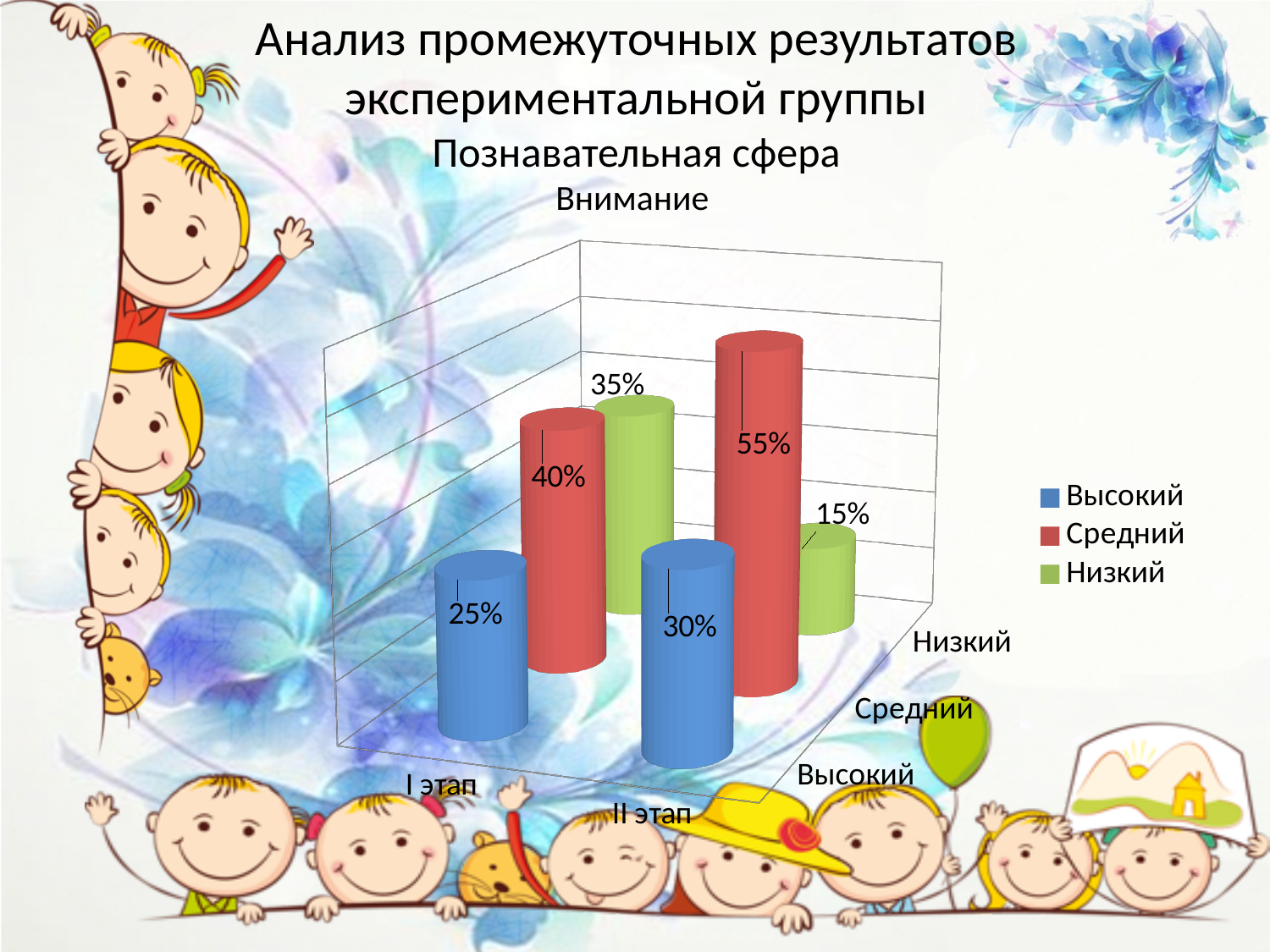
How many series does the legend list? 3 What is the value for Низкий at I этап? 35% How many stages (categories) are shown on the x axis? 2 What is the difference between the Средний values at II этап and I этап? 15% What is the value for Высокий at I этап? 25% What is the value for Средний at II этап? 55% Which series has the lowest value at I этап? Высокий What kind of chart is shown? Bar chart What is the value for Низкий at II этап? 15% Which series has the highest value at II этап? Средний Which is larger: Низкий at I этап or Низкий at II этап? Низкий at I этап What is the title of the chart? Внимание